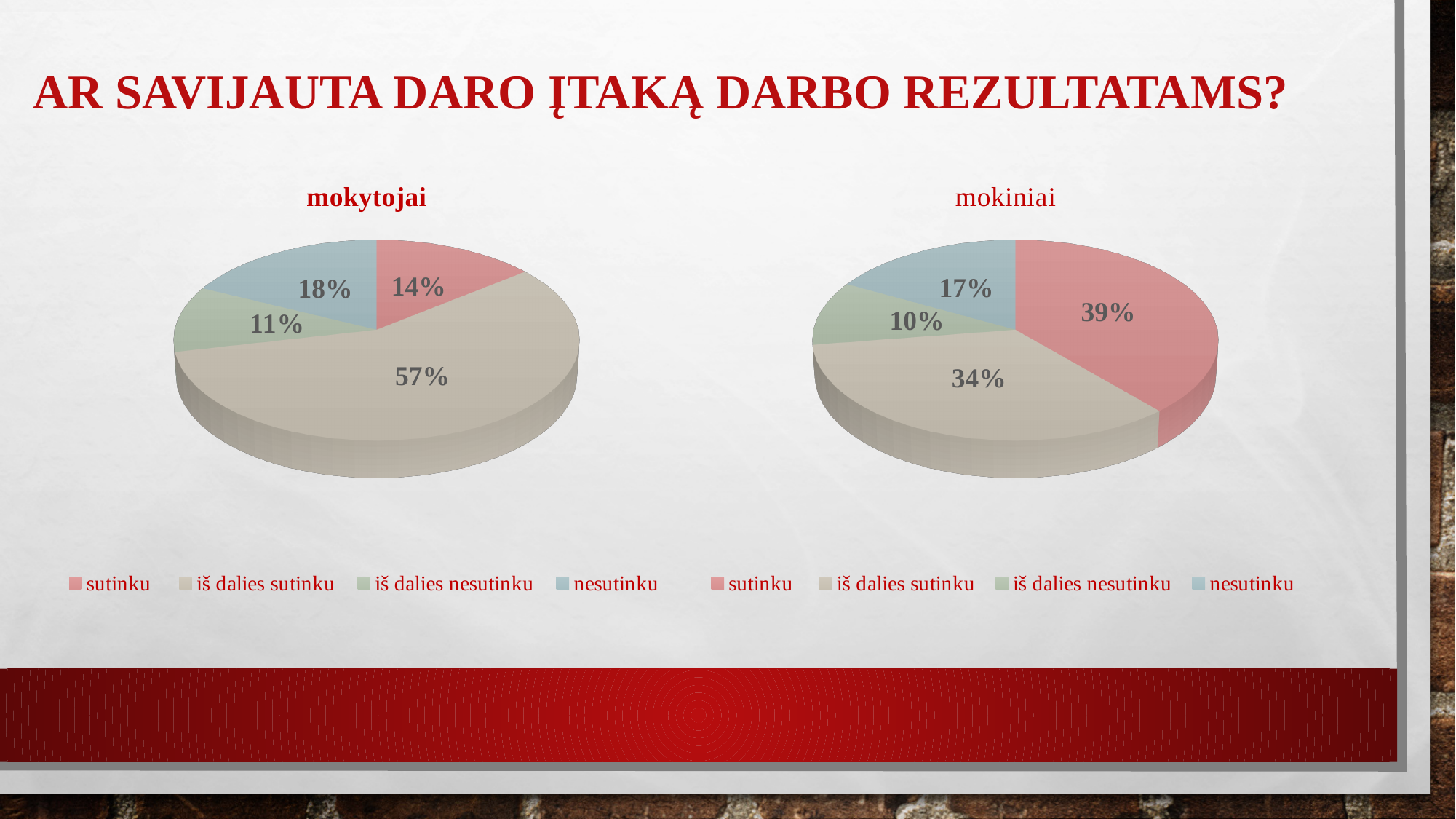
In the "mokiniai" chart, which is larger: "sutinku" or "iš dalies sutinku"? sutinku In the "mokiniai" chart, what share of the pie is "sutinku"? 39% In the "mokiniai" chart, what is the value for "iš dalies nesutinku"? 10% In the "mokytojai" chart, which category has the smallest slice? iš dalies nesutinku What is the difference between the "sutinku" share in the "mokiniai" chart and the "sutinku" share in the "mokytojai" chart? 25% How many slices does the "mokytojai" pie chart have? 4 In the "mokytojai" chart, which category has the largest slice? iš dalies sutinku In the "mokytojai" chart, what share of the pie is "iš dalies sutinku"? 57% In the "mokytojai" chart, what colour is the "nesutinku" slice? blue In the "mokiniai" chart, which category has the smallest slice? iš dalies nesutinku What type of chart is the "mokiniai" chart? pie chart In the "mokytojai" chart, what is the value for "nesutinku"? 18%